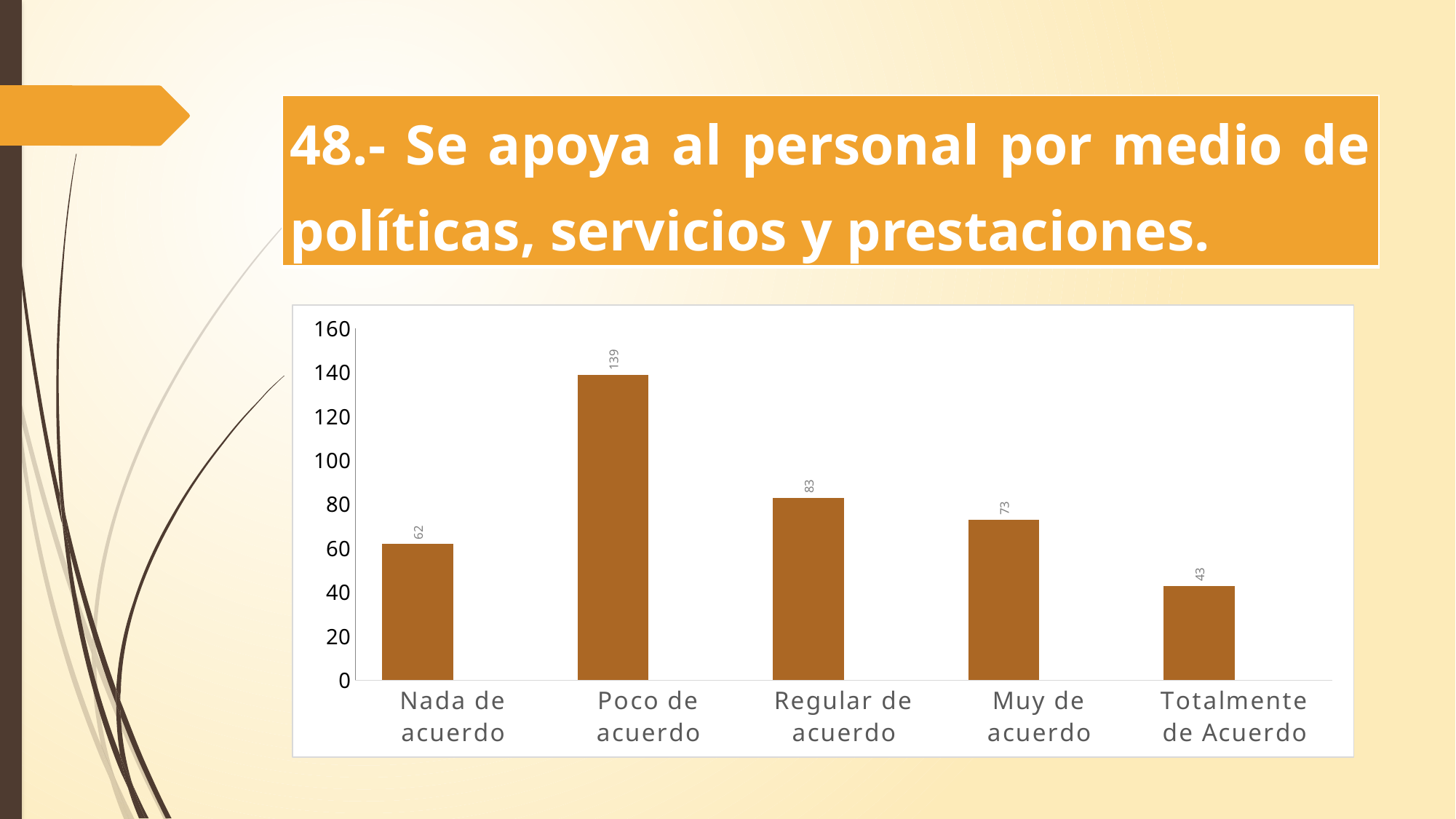
What is the value for Totalmente de Acuerdo? 43 What kind of chart is shown on the slide? bar chart What is the difference between the values for Poco de acuerdo and Regular de acuerdo? 56 What is the value for Nada de acuerdo? 62 Is the value for Poco de acuerdo greater or less than 120? greater Which category has the highest value? Poco de acuerdo What is the value for Poco de acuerdo? 139 Which category has the lowest value? Totalmente de Acuerdo What is the difference between the values for Nada de acuerdo and Totalmente de Acuerdo? 19 What is the value for Muy de acuerdo? 73 Which is larger, the value for Regular de acuerdo or the value for Muy de acuerdo? Regular de acuerdo How many categories are shown on the x axis? 5